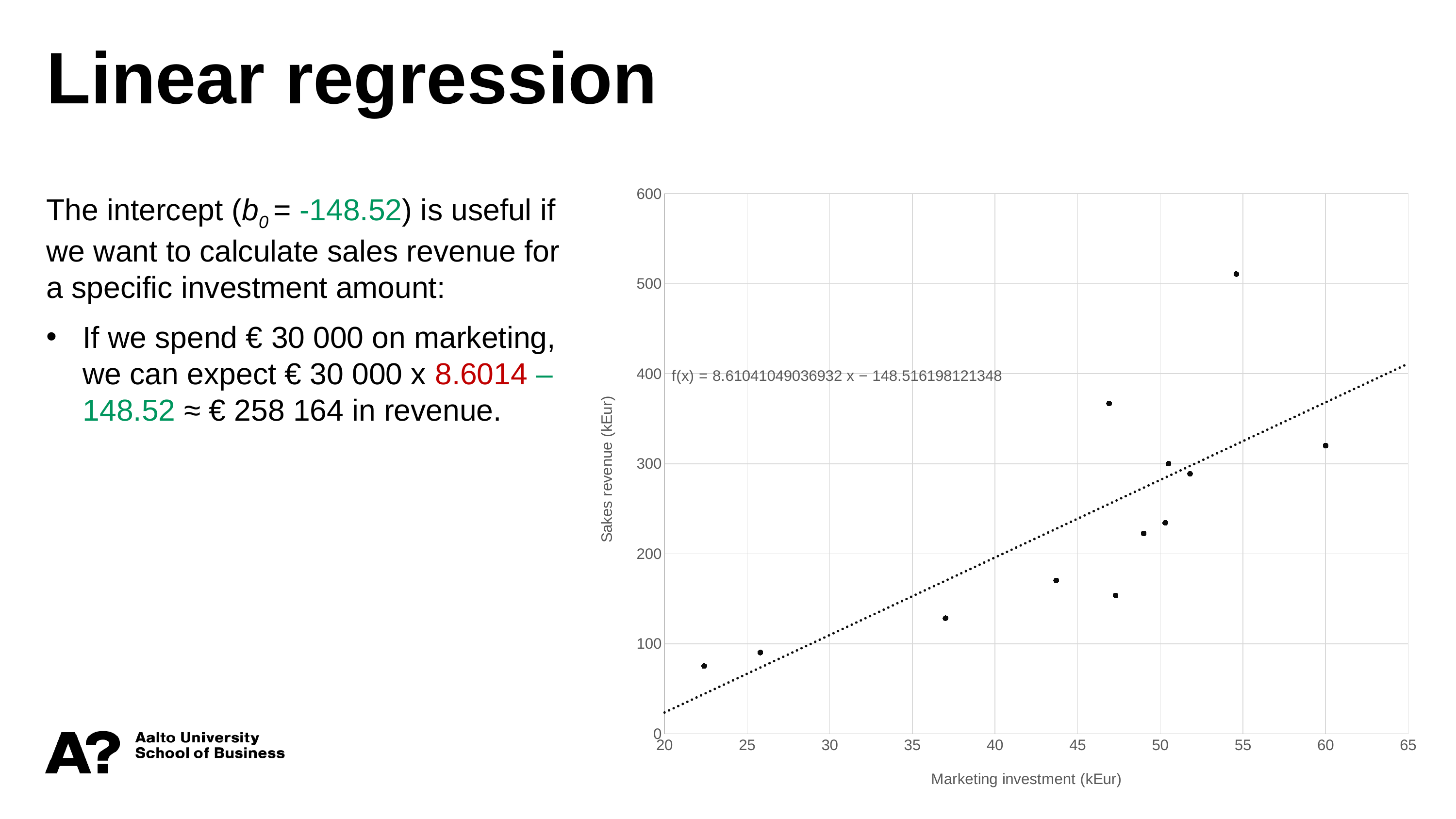
Is the sales revenue of the leftmost plotted point (lowest marketing investment) greater or less than 100? less Is the sales revenue of the point at a marketing investment of about 37 kEur greater or less than 200? less Is the sales revenue of the highest plotted point greater or less than 400? greater What is the title of the x axis of the chart? Marketing investment (kEur) Do the plotted sales revenue values generally rise or fall as marketing investment increases along the x axis? Rise What equation is printed for the trend line on the chart? f(x) = 8.61041049036932 x − 148.516198121348 How many data points are plotted in the scatter chart? 12 What kind of chart is shown on the slide? Scatter chart